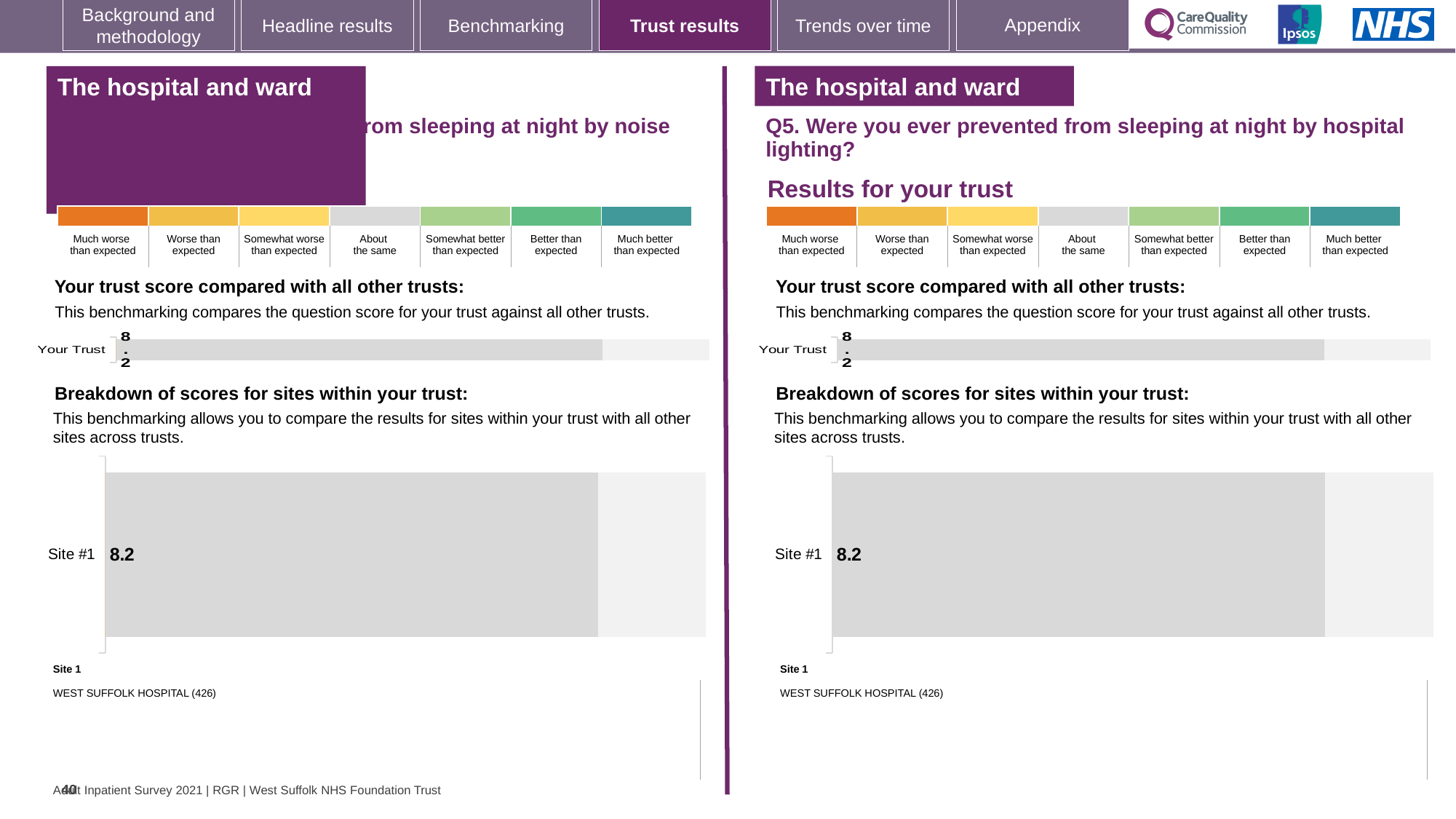
How many sites are plotted on the left-hand 'Breakdown of scores for sites within your trust' chart? 1 How many sites are plotted on the right-hand 'Breakdown of scores for sites within your trust' chart? 1 On the right-hand 'Breakdown of scores for sites within your trust' chart, which hospital is listed as Site 1? WEST SUFFOLK HOSPITAL (426) On the right-hand 'Breakdown of scores for sites within your trust' chart (Q5, hospital lighting), what is the score shown for Site #1? 8.2 What is the difference between the Site #1 score on the left-hand breakdown chart and the Site #1 score on the right-hand breakdown chart? 0 On the left-hand 'Breakdown of scores for sites within your trust' chart, what is the score shown for Site #1? 8.2 Which survey question does the right-hand set of charts relate to? Q5. Were you ever prevented from sleeping at night by hospital lighting? Is the Site #1 score on the right-hand 'Breakdown of scores for sites within your trust' chart (Q5) larger than, smaller than, or equal to the Your Trust score on the right-hand trust comparison chart? Equal On the left-hand 'Your trust score compared with all other trusts' chart, what is the value shown for Your Trust? 8.2 On the right-hand 'Your trust score compared with all other trusts' chart (Q5, hospital lighting), what is the value shown for Your Trust? 8.2 What kind of chart is the right-hand 'Breakdown of scores for sites within your trust' chart? Bar chart